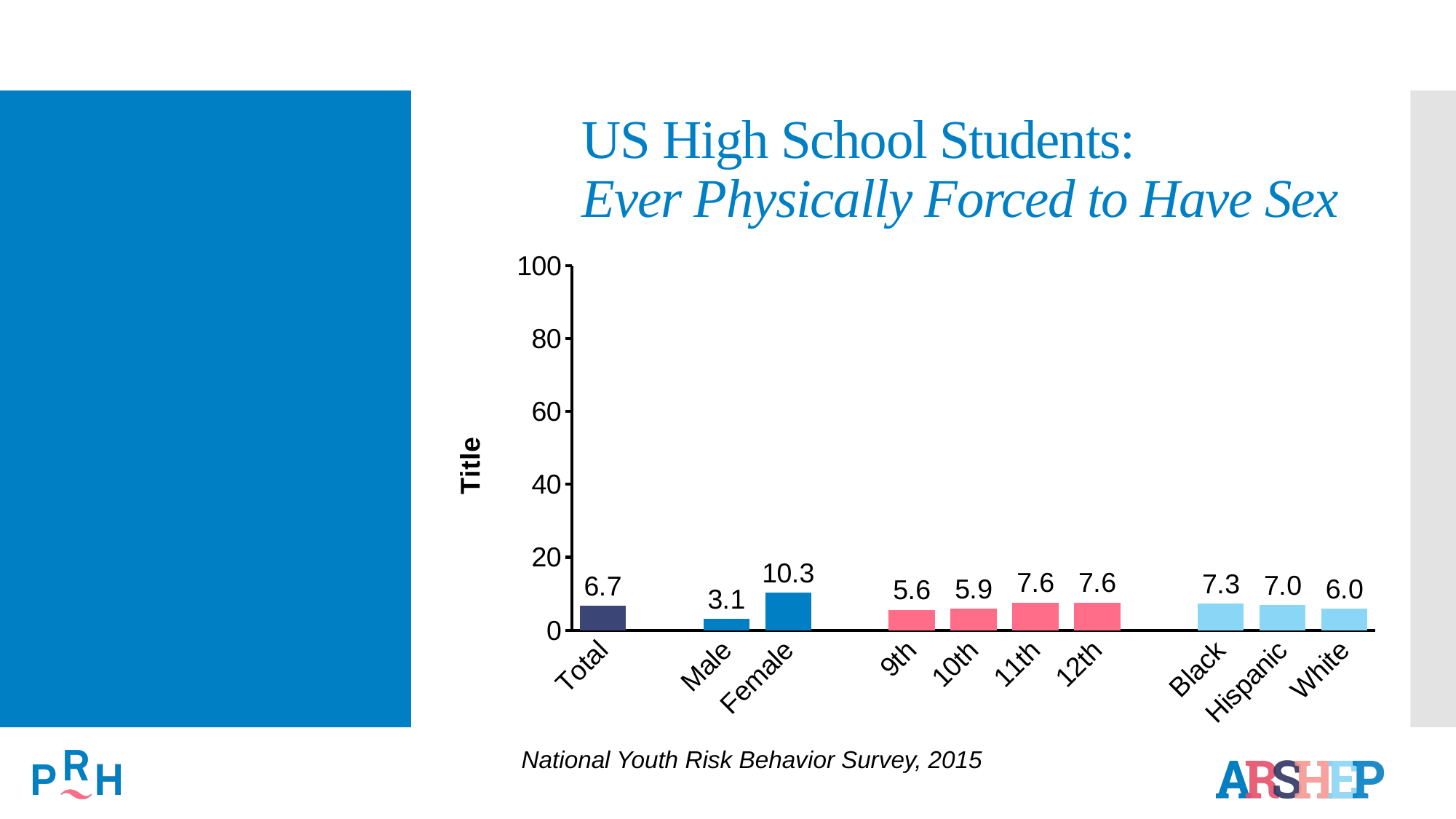
What is the difference between the Female and Male values? 7.2 What is the value for Female? 10.3 How many categories are shown on the x axis? 10 What is the maximum value shown on the y axis? 100 What kind of chart is shown? bar chart Which category has the lowest value? Male What is the value for Hispanic? 7.0 Do the values rise or fall from 9th to 11th grade? rise Is the value for Female greater or less than 20? less Which category has the highest value? Female Which is larger, the value for Black or the value for White? Black What is the value for Total? 6.7